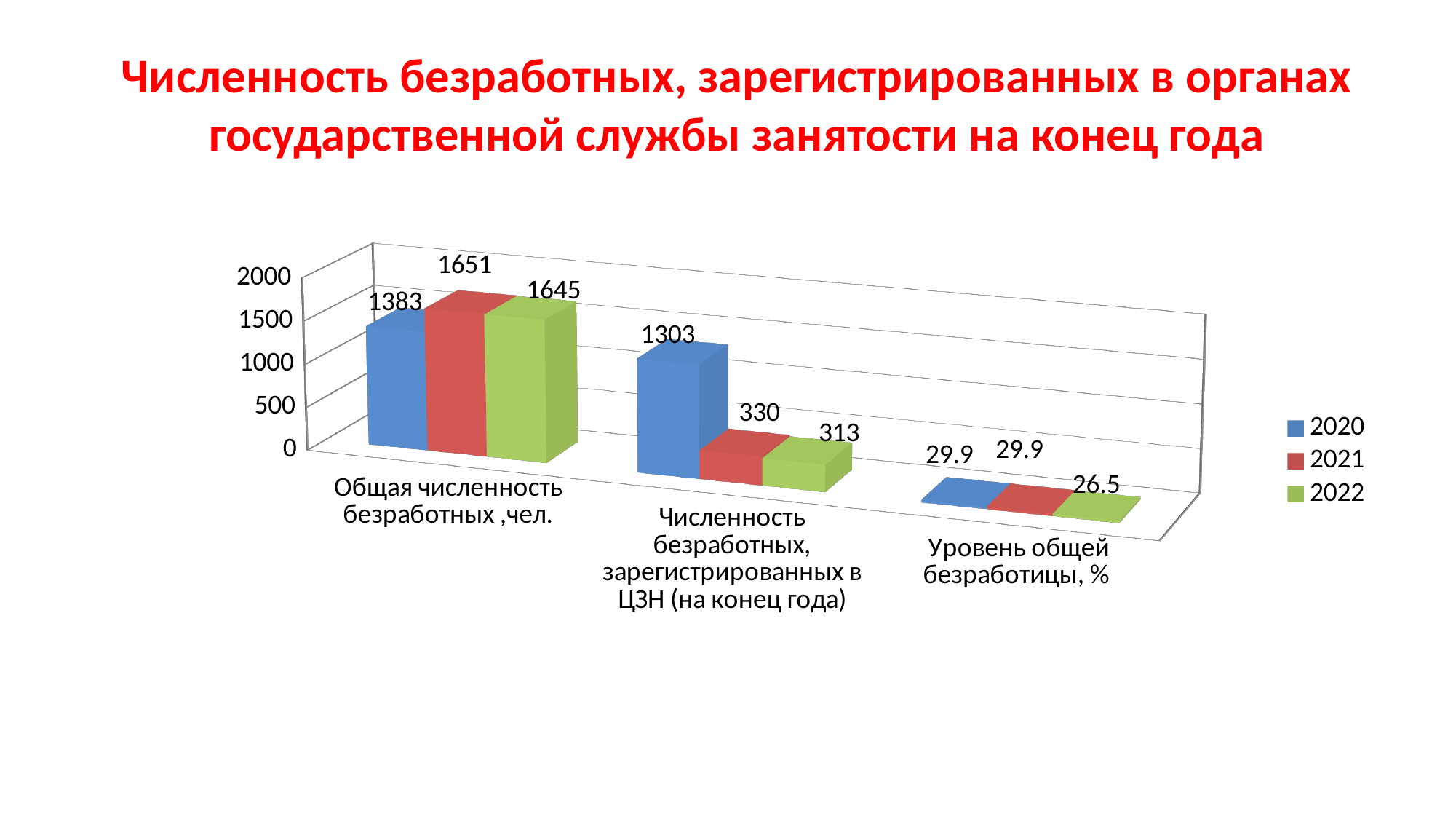
Which year has the highest value in the category "Общая численность безработных, чел."? 2021 How many series does the legend list? 3 What is the difference between the 2021 and 2020 values in the category "Общая численность безработных, чел."? 268 Which is larger: the 2022 value for "Общая численность безработных, чел." or the 2020 value for "Численность безработных, зарегистрированных в ЦЗН (на конец года)"? 2022 value for "Общая численность безработных, чел." What is the value for 2022 in the category "Уровень общей безработицы, %"? 26.5 What is the difference between the 2020 and 2021 values in the category "Численность безработных, зарегистрированных в ЦЗН (на конец года)"? 973 What is the value for 2020 in the category "Общая численность безработных, чел."? 1383 How many categories are shown on the x axis? 3 What kind of chart is shown on the slide? Bar chart Which year has the lowest value in the category "Численность безработных, зарегистрированных в ЦЗН (на конец года)"? 2022 What is the value for 2021 in the category "Численность безработных, зарегистрированных в ЦЗН (на конец года)"? 330 Which colour represents the 2021 series in the legend? Red